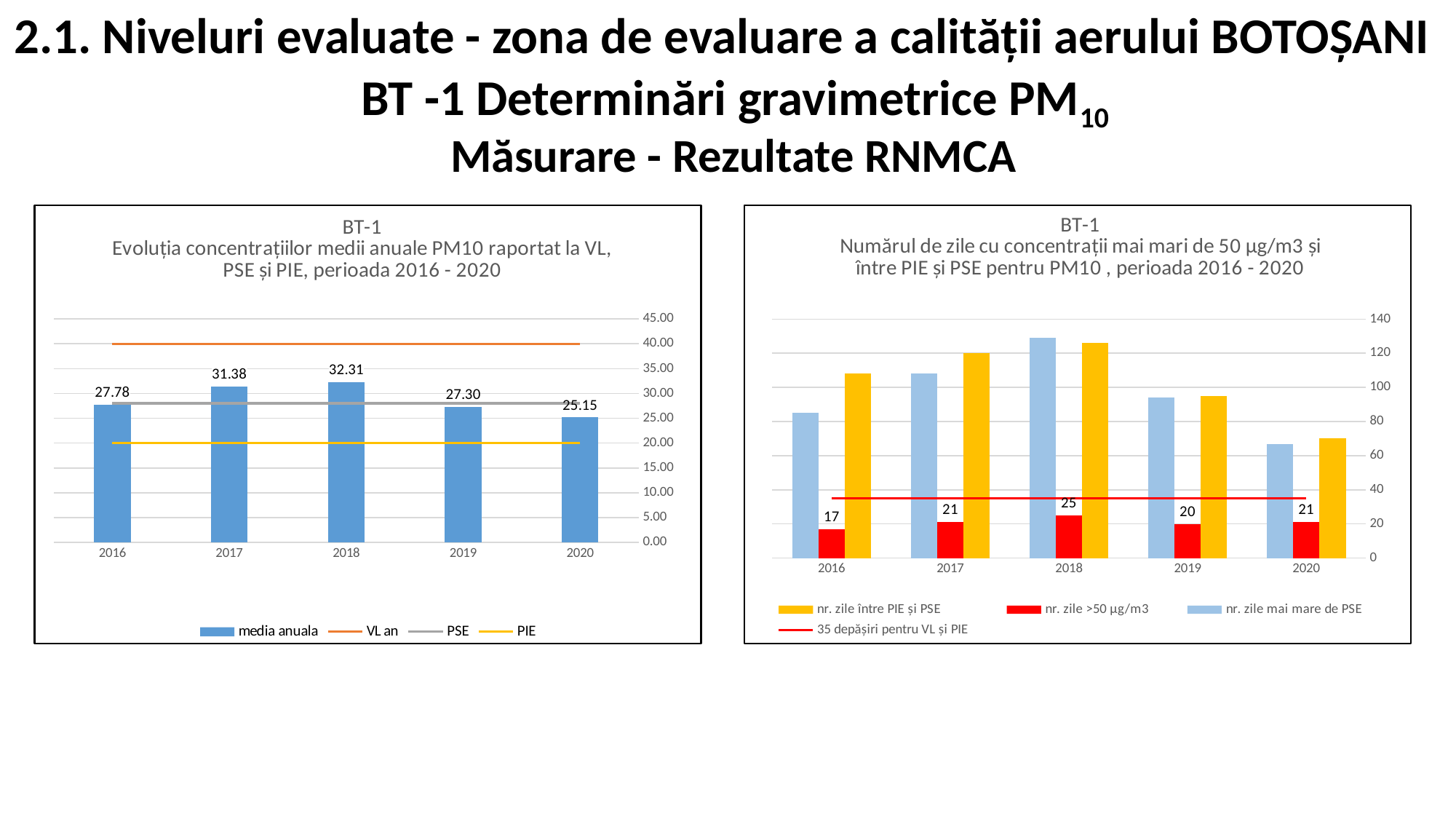
In the left chart (Evoluția concentrațiilor medii anuale PM10), what is the difference between the media anuala values for 2017 and 2016? 3.60 In the left chart (Evoluția concentrațiilor medii anuale PM10), how many series does the legend list? 4 In the left chart (Evoluția concentrațiilor medii anuale PM10), what is the media anuala value for 2020? 25.15 In the left chart (Evoluția concentrațiilor medii anuale PM10), which year has the highest media anuala value? 2018 In the right chart (Numărul de zile cu concentrații mai mari de 50 µg/m3), which year has the lowest value of nr. zile >50 µg/m3? 2016 In the left chart (Evoluția concentrațiilor medii anuale PM10), is the VL an line greater or less than 35.00? greater In the right chart (Numărul de zile cu concentrații mai mari de 50 µg/m3), is the nr. zile mai mare de PSE value for 2018 greater or less than 120? greater In the right chart (Numărul de zile cu concentrații mai mari de 50 µg/m3), what is the difference between the nr. zile >50 µg/m3 values for 2018 and 2016? 8 In the left chart (Evoluția concentrațiilor medii anuale PM10), which year has the lowest media anuala value? 2020 In the right chart (Numărul de zile cu concentrații mai mari de 50 µg/m3), how many years are shown on the x axis? 5 In the right chart (Numărul de zile cu concentrații mai mari de 50 µg/m3), what is the value of nr. zile >50 µg/m3 for 2018? 25 In the left chart (Evoluția concentrațiilor medii anuale PM10), what is the media anuala value for 2018? 32.31